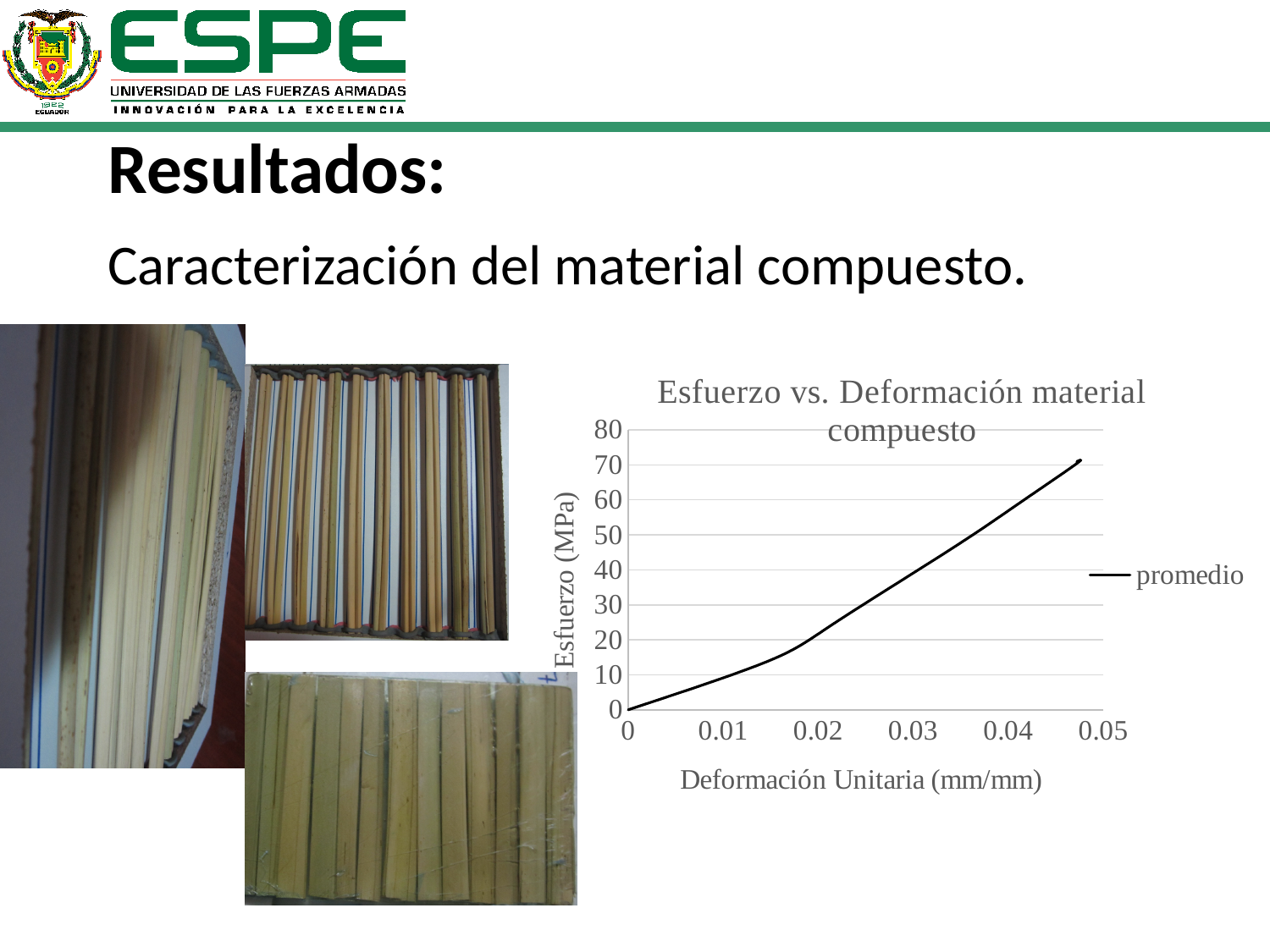
Is the highest value reached by the promedio line greater or less than 60? greater How many series does the chart's legend list? 1 What is the name of the series shown in the legend? promedio What kind of chart is shown on the slide? line chart Is the highest value reached by the promedio line greater or less than 80? less Is the value of the promedio line at a Deformación Unitaria of 0.03 greater or less than 20? greater Does the value of the promedio line rise or fall as Deformación Unitaria increases? rise What is the title of the chart? Esfuerzo vs. Deformación material compuesto